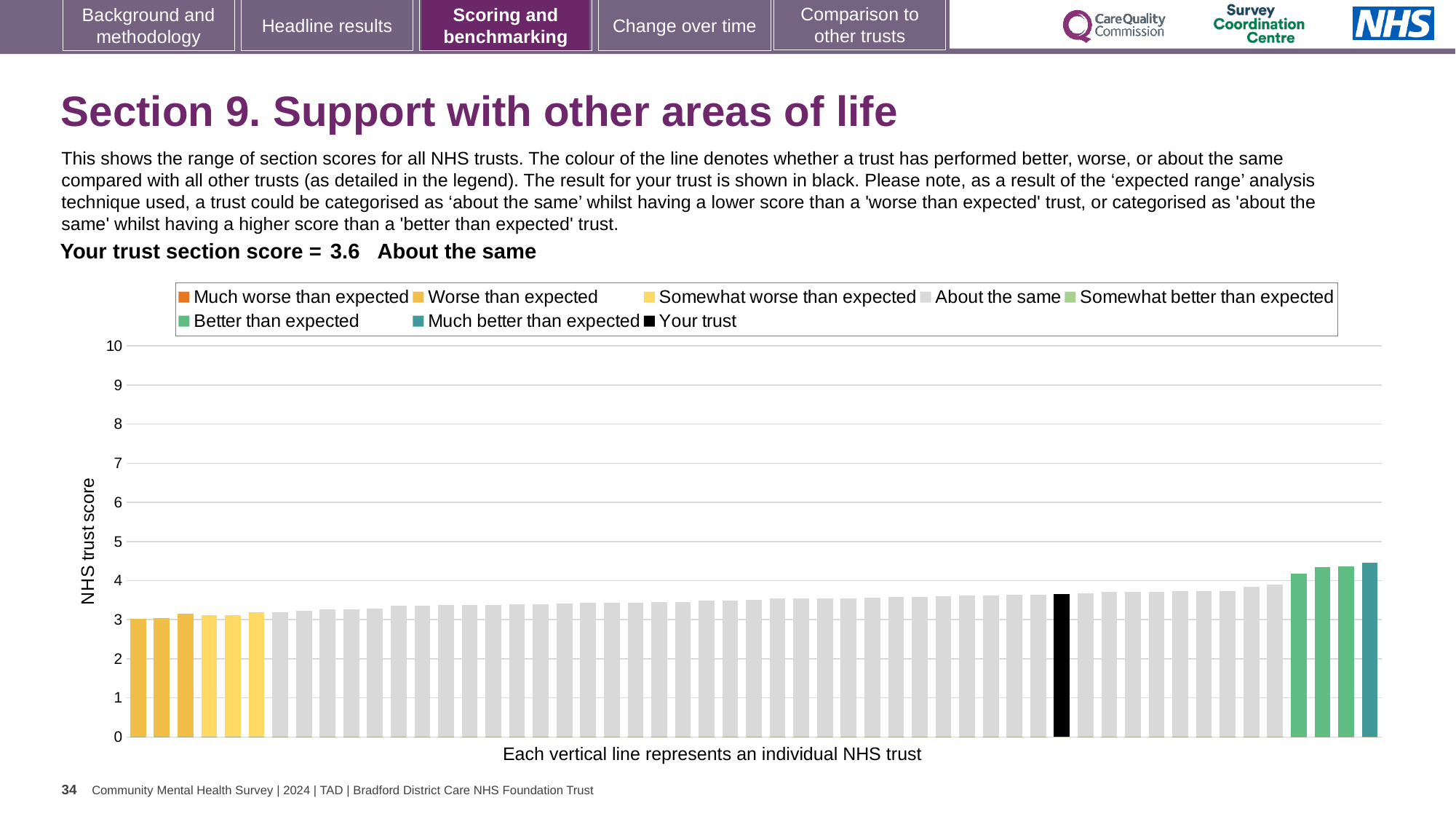
How many bars are coloured as 'Much better than expected' (teal)? 1 How is your trust's section score categorised compared with other trusts? About the same What kind of chart is shown on the slide? bar chart What colour is used for the bar representing your trust? black Do the bar values rise or fall from left to right along the x axis? rise What is the section score for your trust shown on the slide? 3.6 Is the tallest bar in the chart greater or less than 4? greater What is the label on the vertical axis of the chart? NHS trust score How many entries does the chart legend list? 8 Is the value of the black bar (your trust) greater or less than 3? greater Is the value of the black bar (your trust) greater or less than 4? less How many bars are coloured as 'Worse than expected' (yellow)? 3